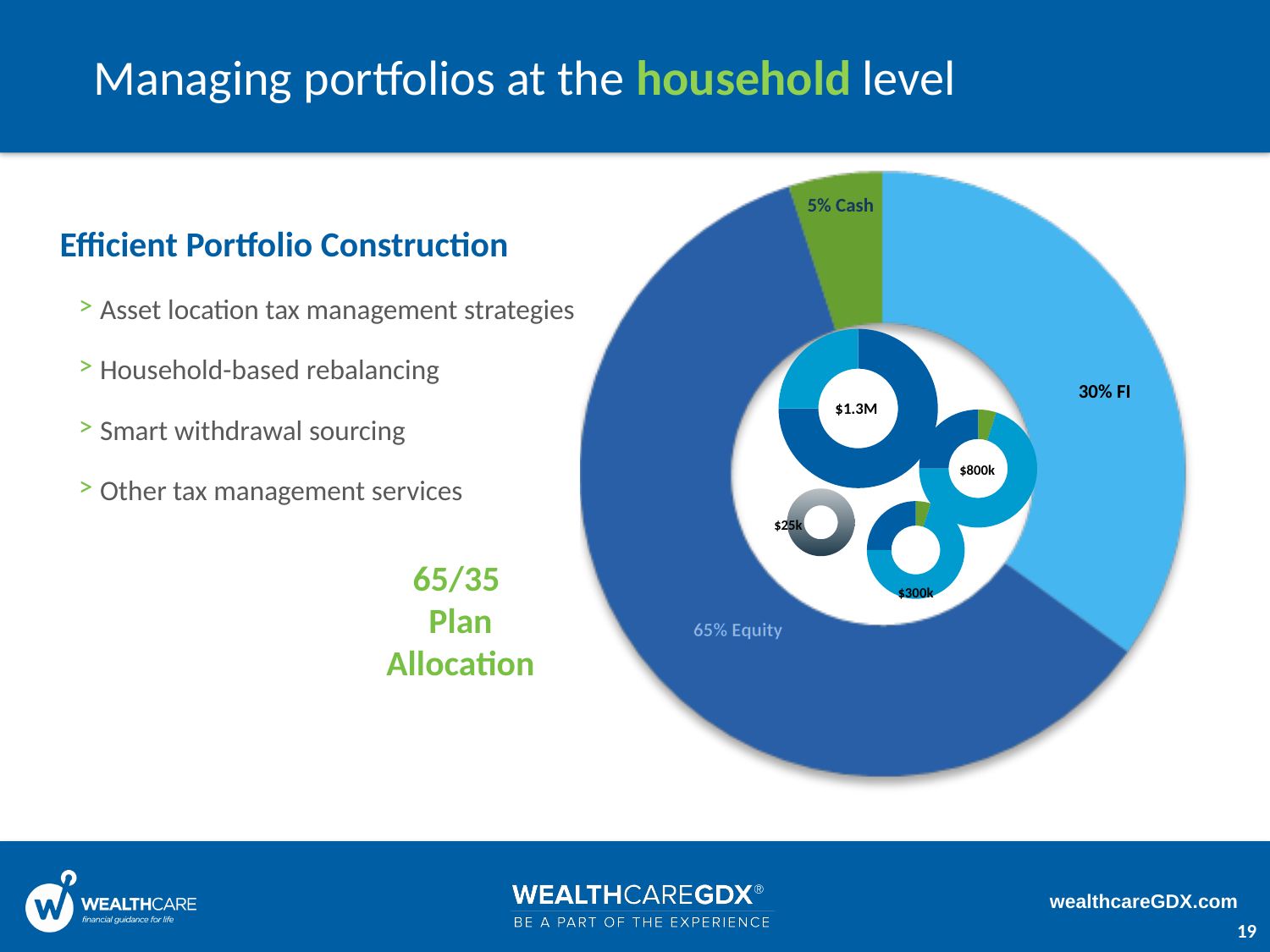
What share of the large donut chart is labelled Cash? 5% Which slice of the large donut chart is the smallest? 5% Cash In the large donut chart, what is the difference in percentage points between the Equity slice and the FI slice? 35 percentage points What kind of chart is the large chart on the right of the slide? Donut (pie) chart What is the value labelled on the largest of the small donut charts inside the main donut? $1.3M How many slices does the large donut chart have? 3 What is the combined share of the FI and Cash slices in the large donut chart? 35% In the large donut chart, which is larger, the FI slice or the Cash slice? FI What share of the large donut chart is labelled Equity? 65% What plan allocation is stated in green text next to the chart? 65/35 Plan Allocation Which slice of the large donut chart is the largest? 65% Equity What share of the large donut chart is labelled FI? 30%